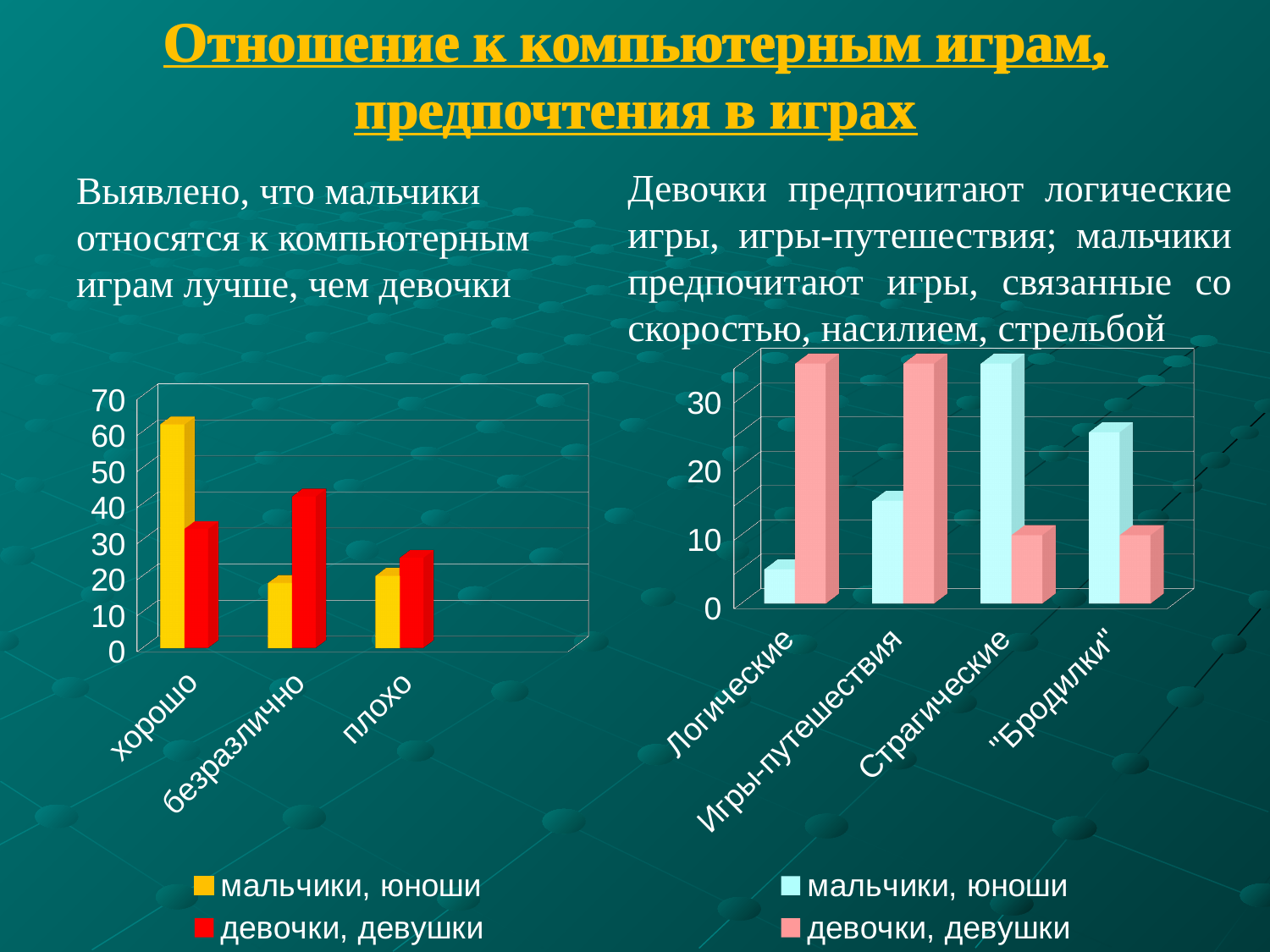
What kind of chart is the left chart? bar chart On the left chart, how many categories are shown on the x axis? 3 On the right chart, which category has the lowest value for мальчики, юноши? Логические On the left chart, in the безразлично category, which series has the larger value: мальчики, юноши or девочки, девушки? девочки, девушки On the left chart, is the value for мальчики, юноши in the хорошо category greater or less than 50? greater On the right chart, is the value for девочки, девушки in the Логические category greater or less than 30? greater On the left chart, how many series does the legend list? 2 On the left chart, which category has the lowest value for девочки, девушки? плохо On the right chart, in the Страгические category, which series has the larger value: мальчики, юноши or девочки, девушки? мальчики, юноши On the right chart, how many categories are shown on the x axis? 4 On the right chart, which colour represents девочки, девушки? pink On the left chart, which category has the highest value for мальчики, юноши? хорошо